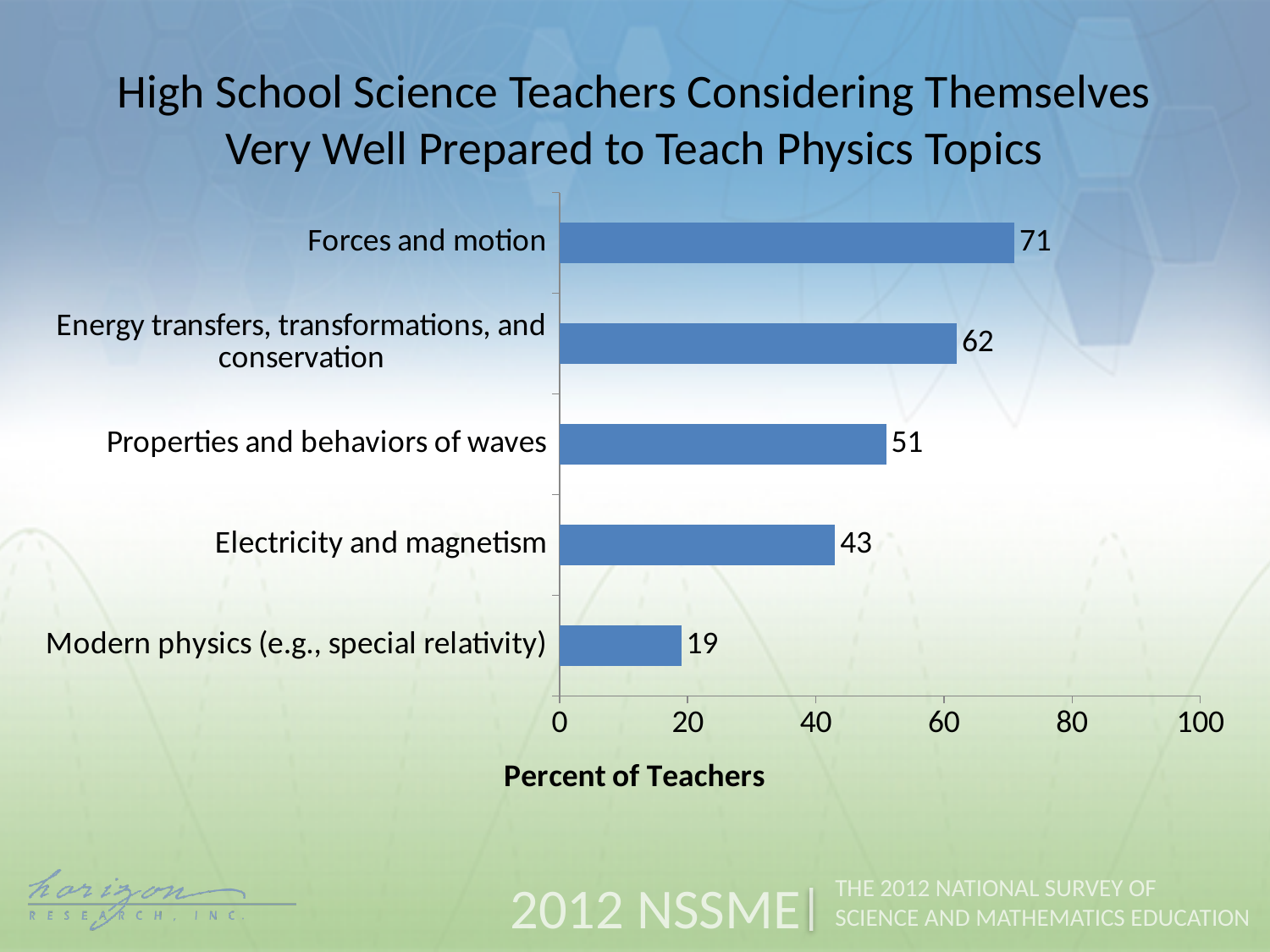
How many physics topics are shown in the chart? 5 What is the label of the horizontal axis? Percent of Teachers Which physics topic has the lowest percent of teachers feeling very well prepared? Modern physics (e.g., special relativity) What is the difference between the values for Forces and motion and Electricity and magnetism? 28 Is the value for Electricity and magnetism greater or less than 40? greater What is the difference between the values for Energy transfers, transformations, and conservation and Modern physics (e.g., special relativity)? 43 What is the value for Modern physics (e.g., special relativity)? 19 What is the value for Properties and behaviors of waves? 51 What percent of teachers consider themselves very well prepared to teach Forces and motion? 71 Which is larger, the value for Energy transfers, transformations, and conservation or the value for Properties and behaviors of waves? Energy transfers, transformations, and conservation Which physics topic has the highest percent of teachers feeling very well prepared? Forces and motion What kind of chart is shown on the slide? Bar chart